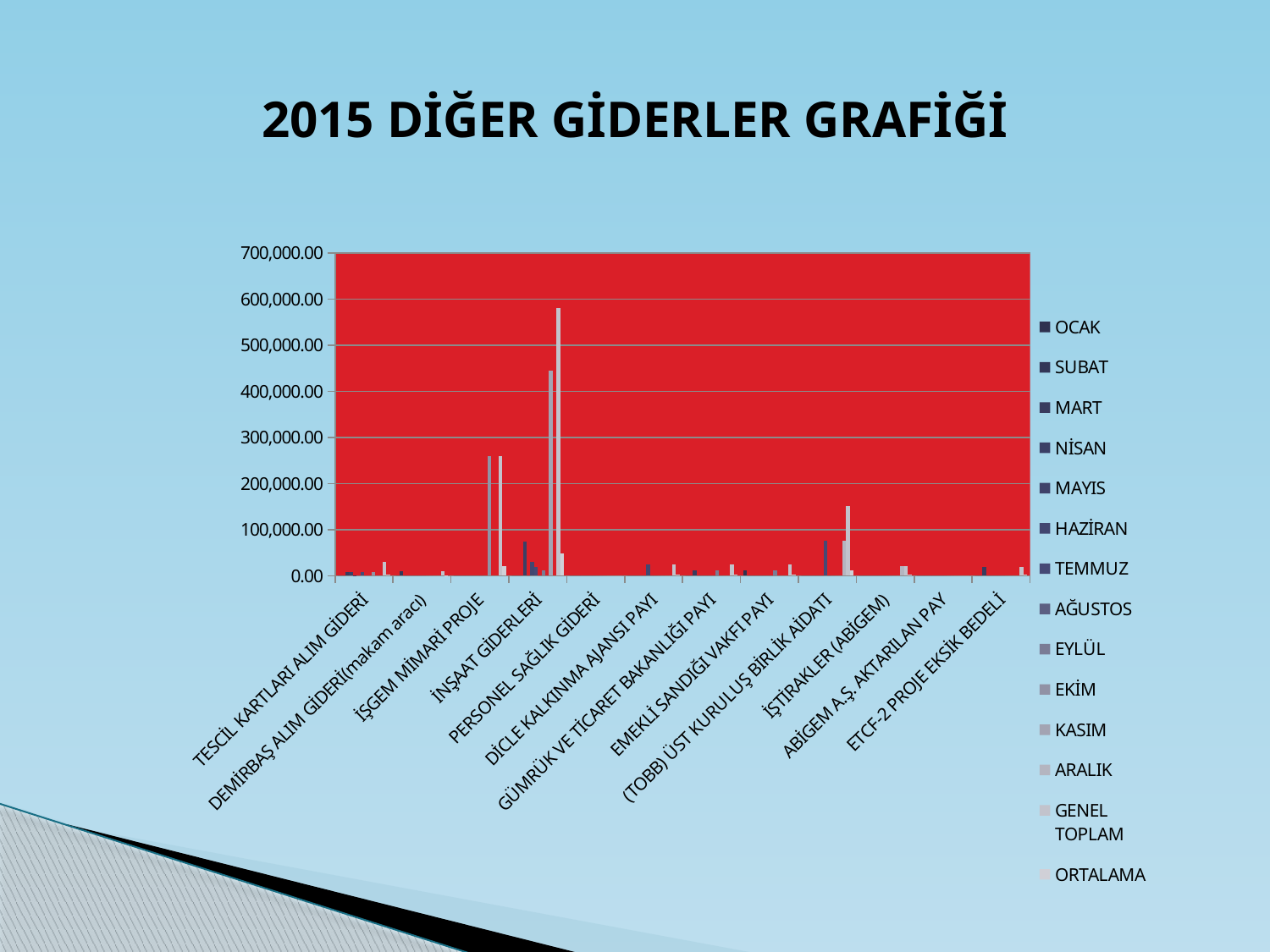
Which category has the taller tallest bar, İNŞAAT GİDERLERİ or İŞGEM MİMARİ PROJE? İNŞAAT GİDERLERİ What is the title of the chart? 2015 DİĞER GİDERLER GRAFİĞİ Is the tallest bar for İŞTİRAKLER (ABİGEM) greater or less than 100,000.00? less Is the tallest bar for İŞTİRAKLER (ABİGEM) greater or less than 200,000.00? less Is the tallest bar for İŞGEM MİMARİ PROJE greater or less than 300,000.00? less Which category has the taller tallest bar, İŞTİRAKLER (ABİGEM) or PERSONEL SAĞLIK GİDERİ? İŞTİRAKLER (ABİGEM) What is the maximum value shown on the vertical axis? 700,000.00 Which category has the tallest bar in the chart? İNŞAAT GİDERLERİ How many series does the legend list? 14 What kind of chart is shown on the slide? bar chart